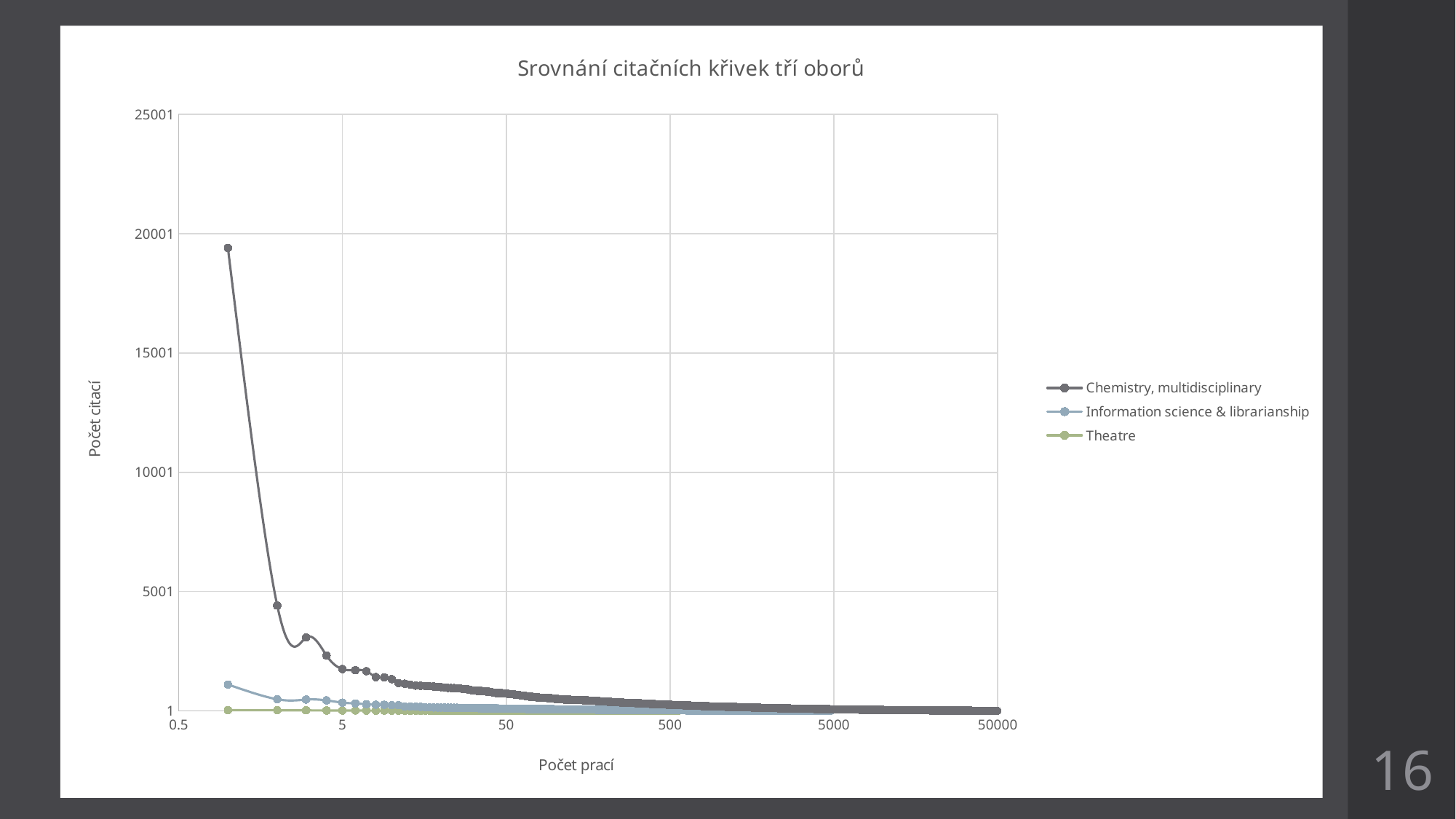
Is the highest value of the Information science & librarianship series greater or less than 5001? less Is the highest value of the Chemistry, multidisciplinary series greater or less than 20001? less Which series has the lowest values across the chart? Theatre How many series does the legend list? 3 What is the title of the chart? Srovnání citačních křivek tří oborů At the first point on the x axis, which series has the larger value: Chemistry, multidisciplinary or Information science & librarianship? Chemistry, multidisciplinary Is the highest value of the Chemistry, multidisciplinary series greater or less than 15001? greater Do the values of the Chemistry, multidisciplinary series rise or fall as the number of works increases along the x axis? fall Which series reaches the highest number of citations? Chemistry, multidisciplinary What is the largest value shown on the x axis? 50000 What is the label of the vertical axis? Počet citací What kind of chart is shown on the slide? line chart